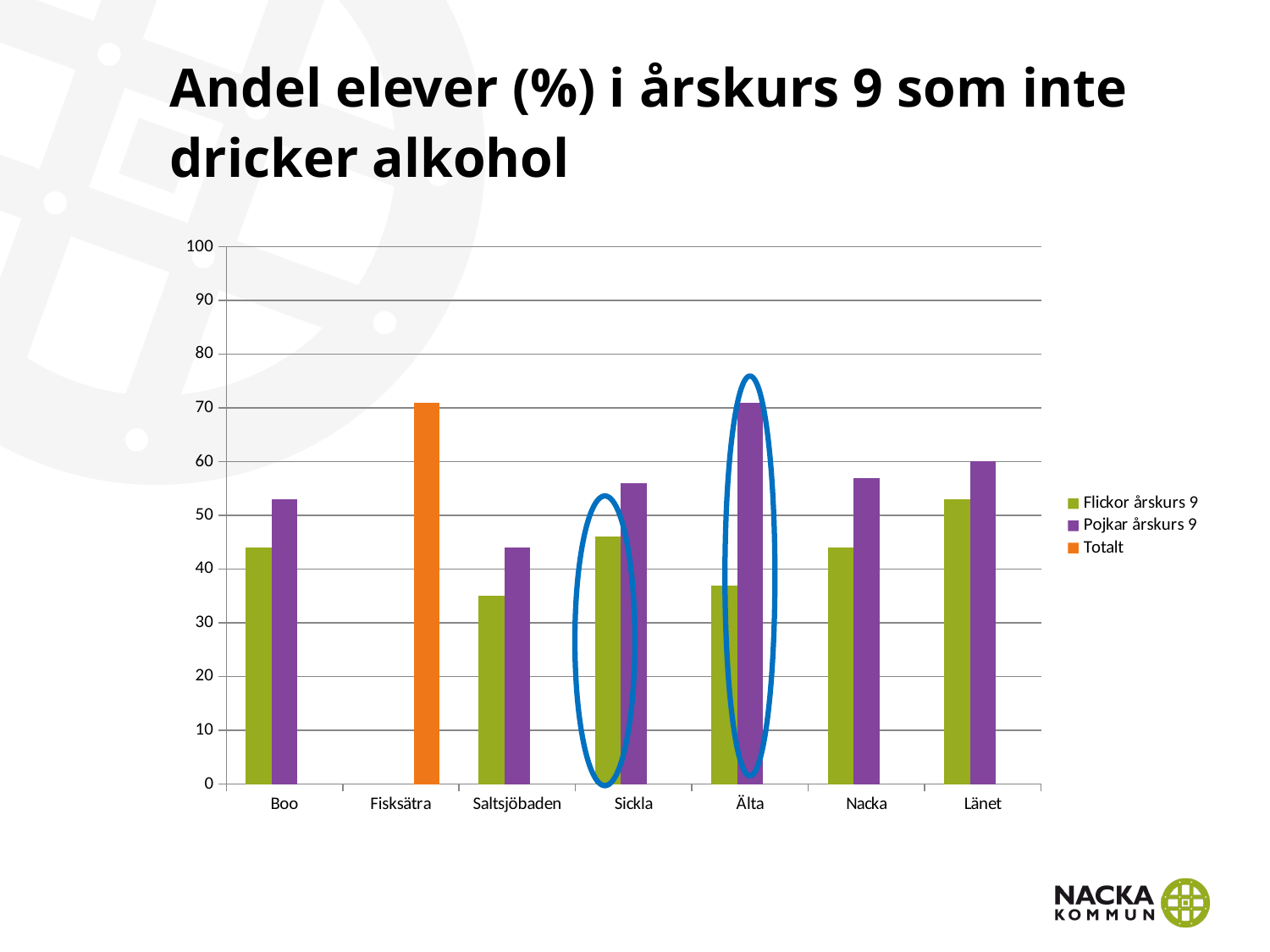
How many series does the legend list? 3 Is the value for Flickor årskurs 9 in Saltsjöbaden greater or less than 40? less What kind of chart is shown on the slide? bar chart In Sickla, which is larger: Flickor årskurs 9 or Pojkar årskurs 9? Pojkar årskurs 9 Which category has the highest value for Pojkar årskurs 9? Älta Which category shows only a Totalt bar? Fisksätra Is the value for Pojkar årskurs 9 in Älta greater or less than 60? greater How many categories are shown on the x axis? 7 Which category has the highest value for Flickor årskurs 9? Länet Is the value for Flickor årskurs 9 in Sickla greater or less than 50? less Which is larger: Flickor årskurs 9 in Länet or Flickor årskurs 9 in Boo? Länet